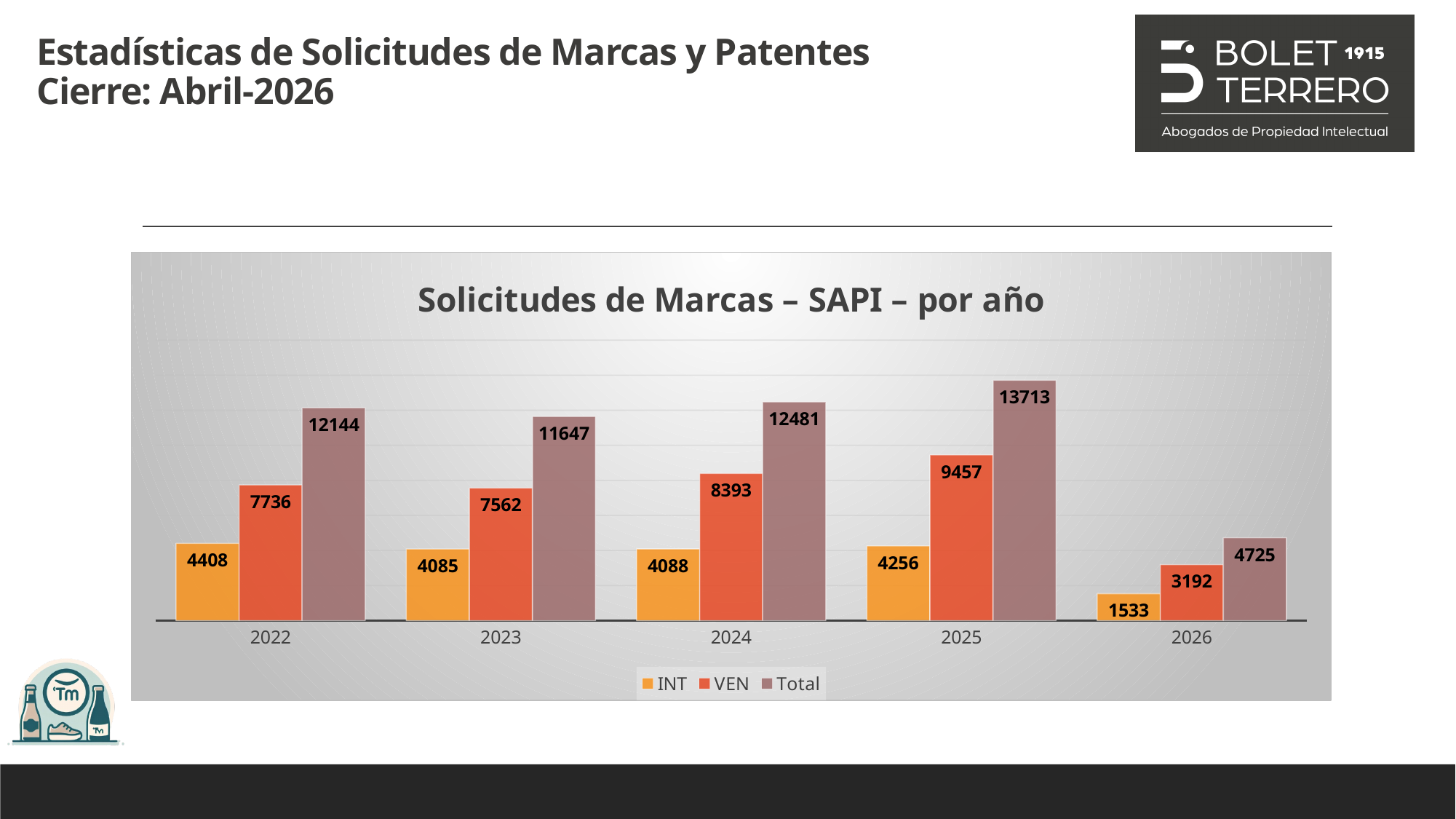
What is the VEN value for 2026? 3192 What is the Total value for 2025? 13713 Which is larger, the INT value for 2022 or the INT value for 2025? 2022 What is the VEN value for 2024? 8393 What is the INT value for 2022? 4408 What is the difference between the VEN values for 2025 and 2024? 1064 How many years are shown on the x axis? 5 Which year has the highest Total value? 2025 How many series does the legend list? 3 What kind of chart is shown on the slide? Bar chart What is the title of the chart? Solicitudes de Marcas – SAPI – por año Which year has the lowest INT value? 2026